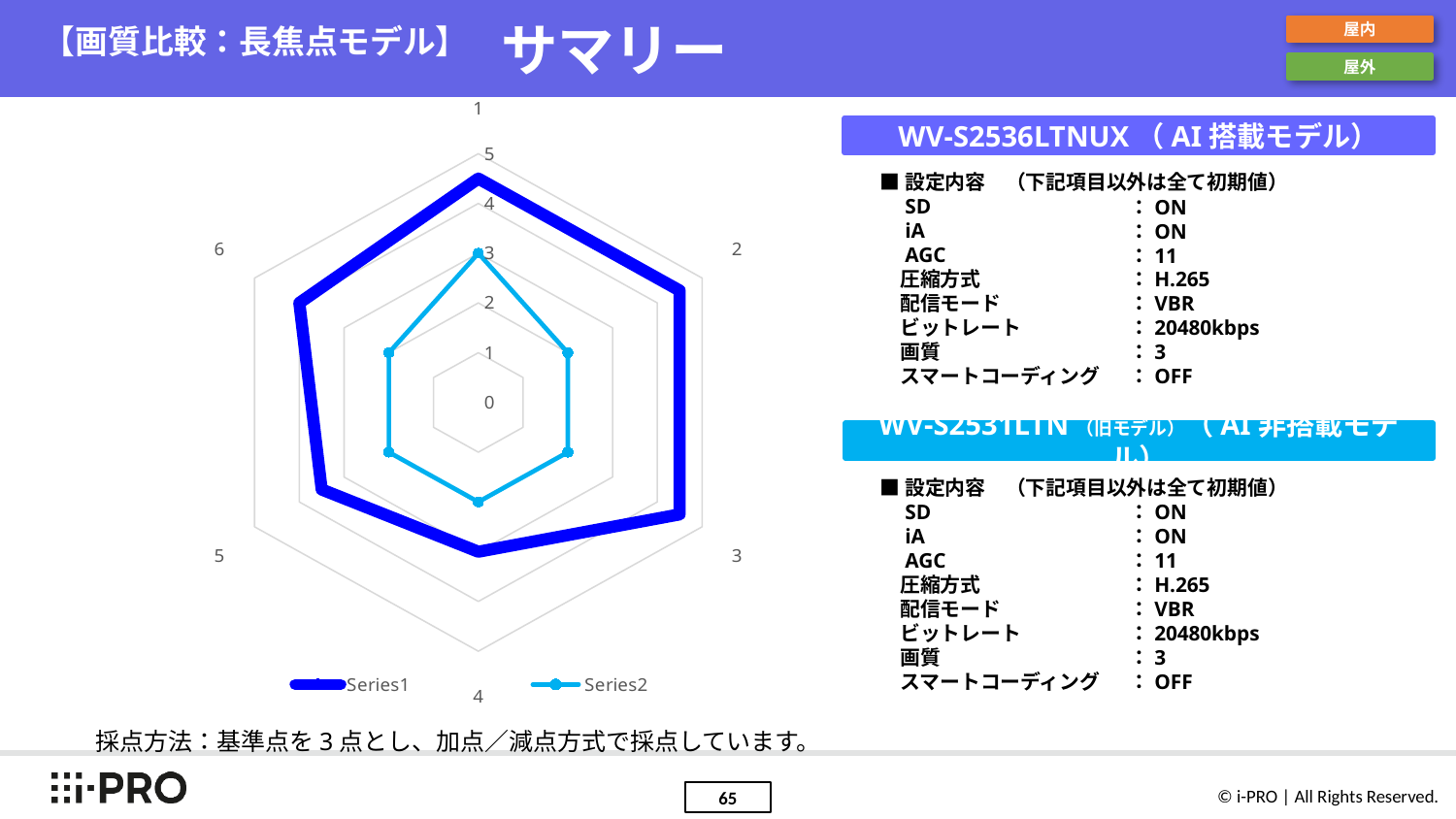
What kind of chart is shown on the slide? radar chart Is the value of Series1 for category 3 greater or less than 3? greater Is the value of Series1 for category 1 greater or less than 4? greater Which series has the larger value for category 5, Series1 or Series2? Series1 Is the value of Series2 for category 2 greater or less than 4? less Which series has the larger value for category 2, Series1 or Series2? Series1 How many series does the chart legend list? 2 What is the highest value shown on the radar chart's scale? 5 What are the names of the two series in the legend? Series1, Series2 Which series is drawn with the thick dark blue line? Series1 How many categories (axes) does the radar chart have? 6